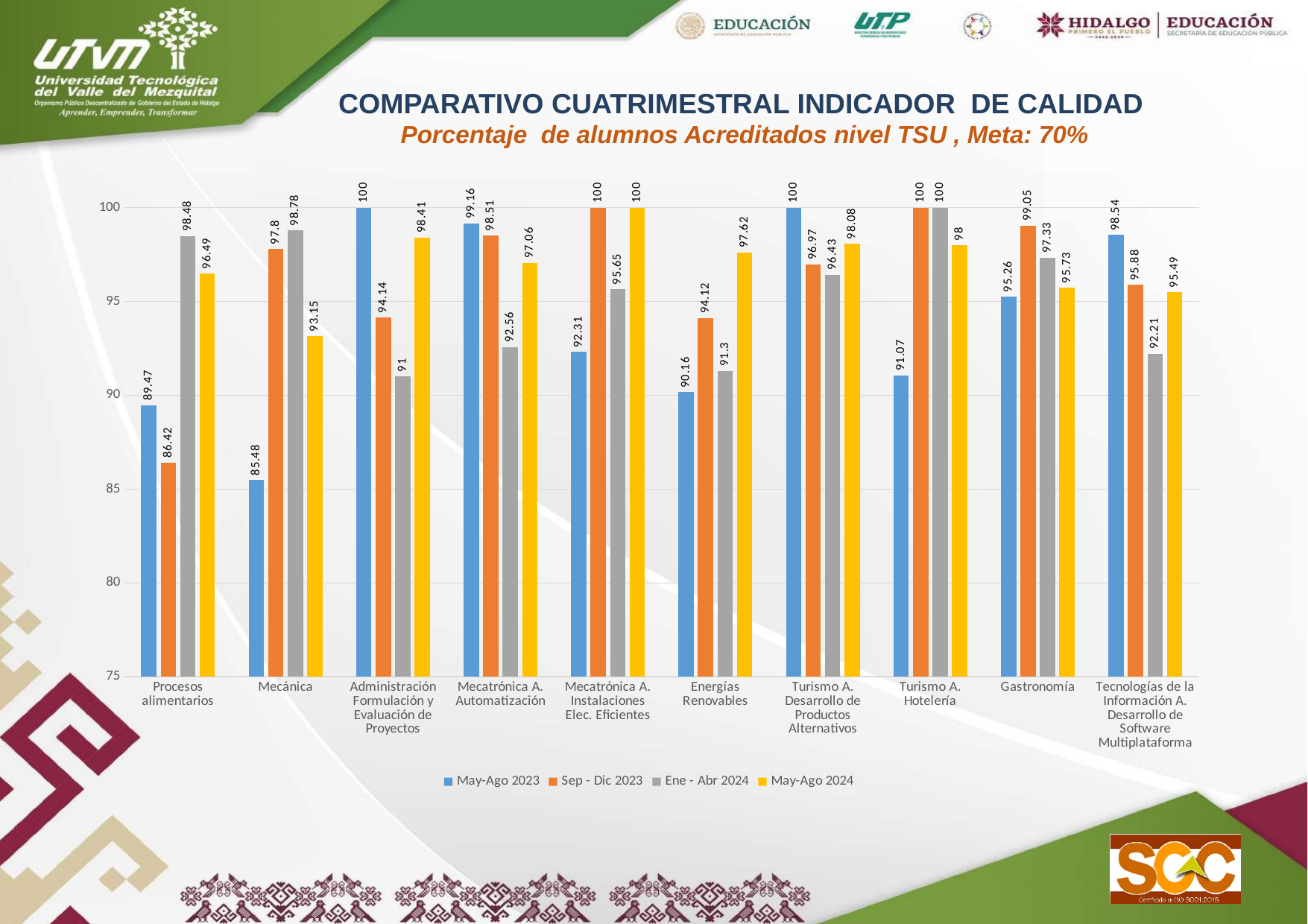
Which is larger for Turismo A. Hotelería: the May-Ago 2023 value or the May-Ago 2024 value? May-Ago 2024 How many series does the legend list? 4 Which category has the lowest value in the Sep - Dic 2023 series? Procesos alimentarios What is the value for Energías Renovables in the May-Ago 2024 series? 97.62 What kind of chart is shown on the slide? Bar chart What is the difference between the Sep - Dic 2023 and May-Ago 2023 values for Mecánica? 12.32 What is the value for Mecánica in the May-Ago 2023 series? 85.48 What is the value for Procesos alimentarios in the Ene - Abr 2024 series? 98.48 Which category has the lowest value in the May-Ago 2023 series? Mecánica What is the value for Gastronomía in the Sep - Dic 2023 series? 99.05 How many categories (programs) are shown on the x axis? 10 What target (Meta) is stated in the chart subtitle? 70%